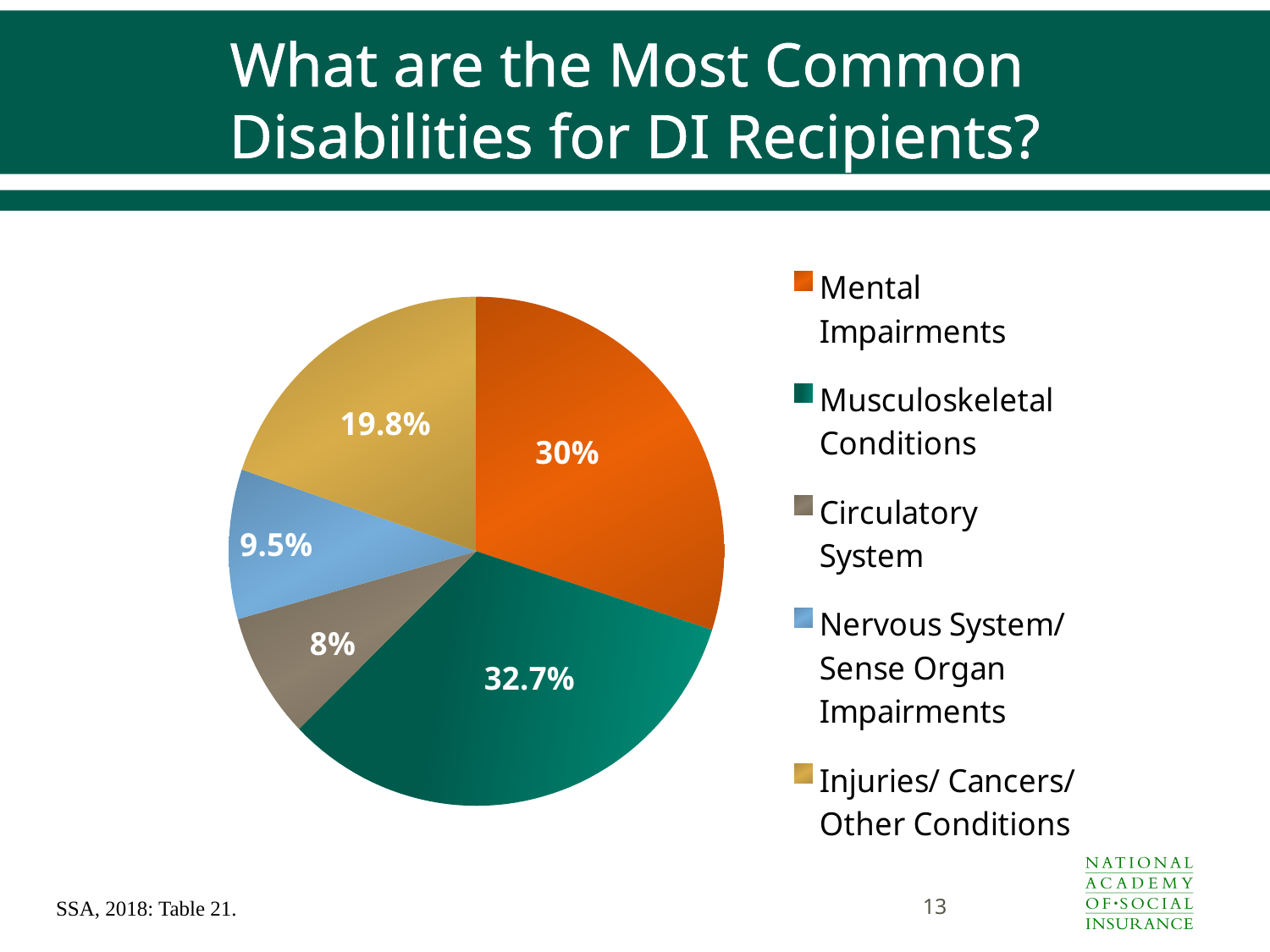
What share of DI recipients have Circulatory System disabilities? 8% What share of DI recipients have Injuries/Cancers/Other Conditions? 19.8% What is the difference in percentage points between Musculoskeletal Conditions and Mental Impairments? 2.7 Which category has the largest share of the pie? Musculoskeletal Conditions What share of DI recipients have Musculoskeletal Conditions? 32.7% What kind of chart is shown on the slide? pie chart Which is larger: the share for Injuries/Cancers/Other Conditions or the share for Nervous System/Sense Organ Impairments? Injuries/Cancers/Other Conditions What share of DI recipients have Mental Impairments? 30% How many categories does the pie chart show? 5 What colour is the slice for Mental Impairments? orange What share of DI recipients have Nervous System/Sense Organ Impairments? 9.5% Which category has the smallest share of the pie? Circulatory System